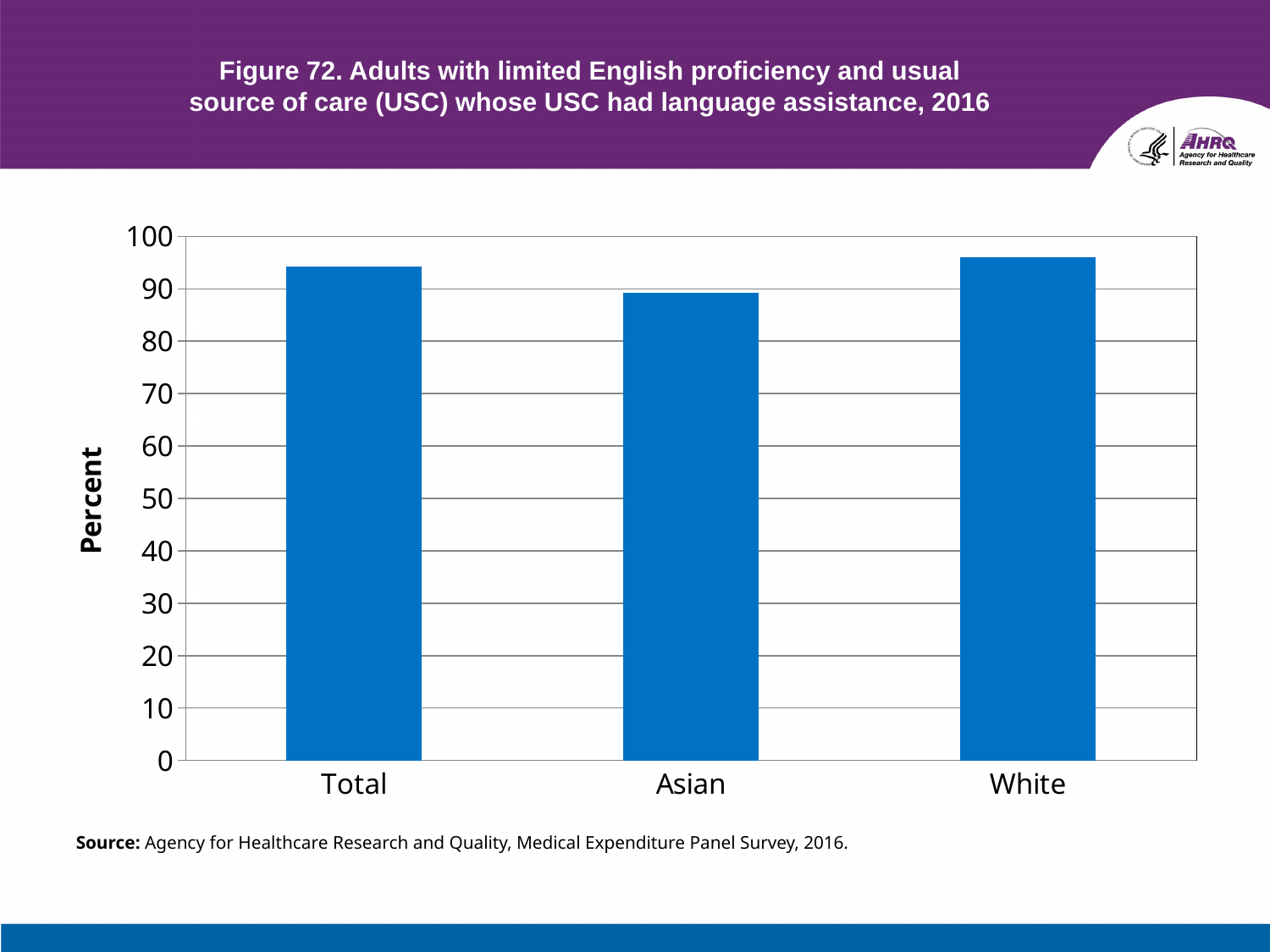
Which is larger, the value for Asian or the value for White? White What is the label on the y axis of the chart? Percent Which category has the highest value in the chart? White How many categories are shown on the x axis of the chart? 3 Which is larger, the value for Total or the value for Asian? Total What kind of chart is shown on the slide? bar chart Which category has the lowest value in the chart? Asian Is the value for Total greater or less than 100? less What is the figure number given in the chart title? Figure 72 Is the value for Total greater or less than 90? greater Is the value for White greater or less than 90? greater